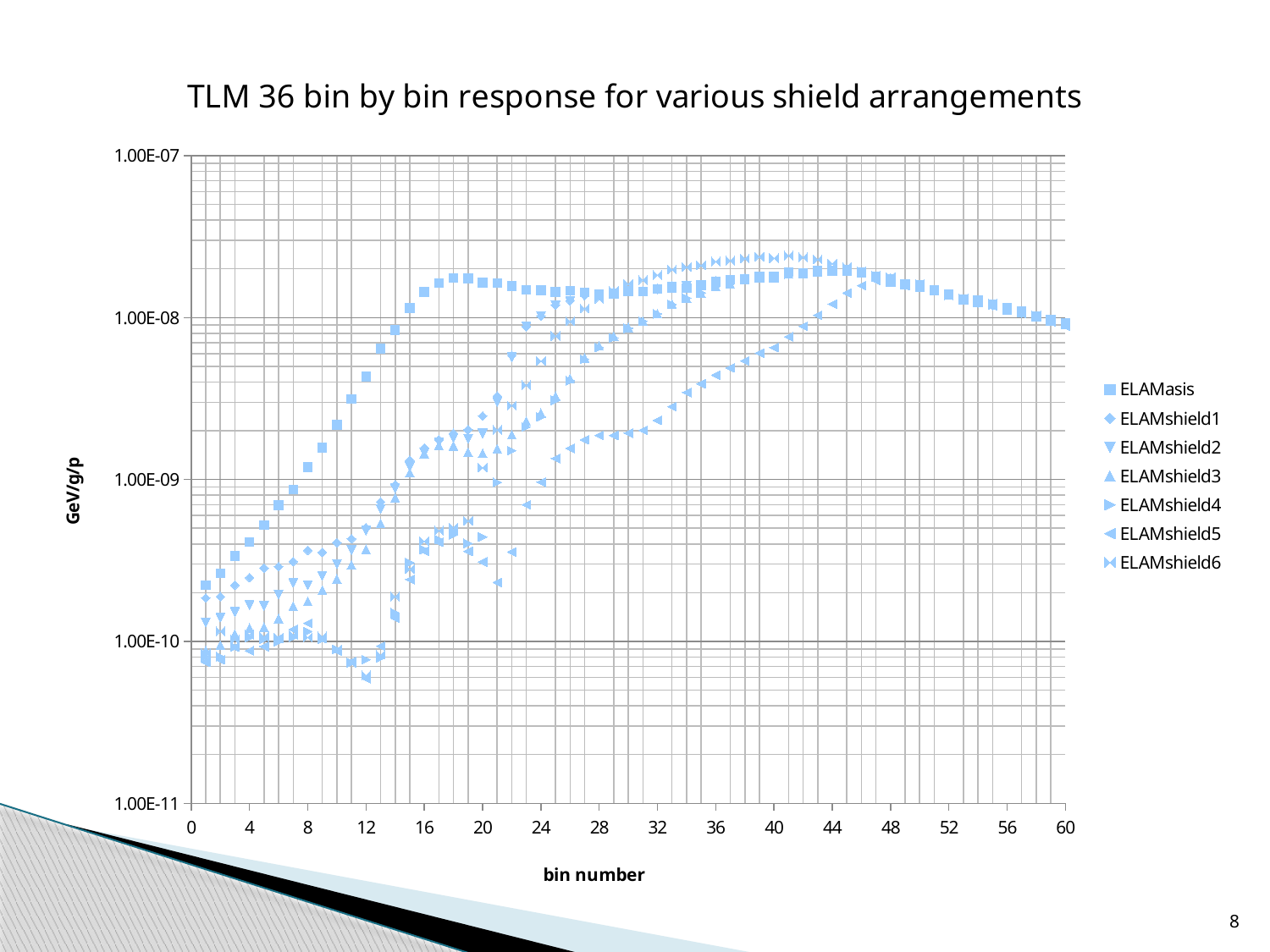
What kind of chart is shown on the slide? scatter chart How many series does the legend list? 7 Is the value for ELAMshield5 at bin 32 greater or less than 1.00E-09? greater At bin 12, which series has the larger value, ELAMasis or ELAMshield1? ELAMasis Is the value for ELAMasis at bin 1 greater or less than 1.00E-10? greater What is the label of the y axis? GeV/g/p Is the value for ELAMasis at bin 40 greater or less than 1.00E-08? greater Do the ELAMasis values rise or fall from bin 1 to bin 20? rise What is the title of the chart? TLM 36 bin by bin response for various shield arrangements What is the label of the x axis? bin number